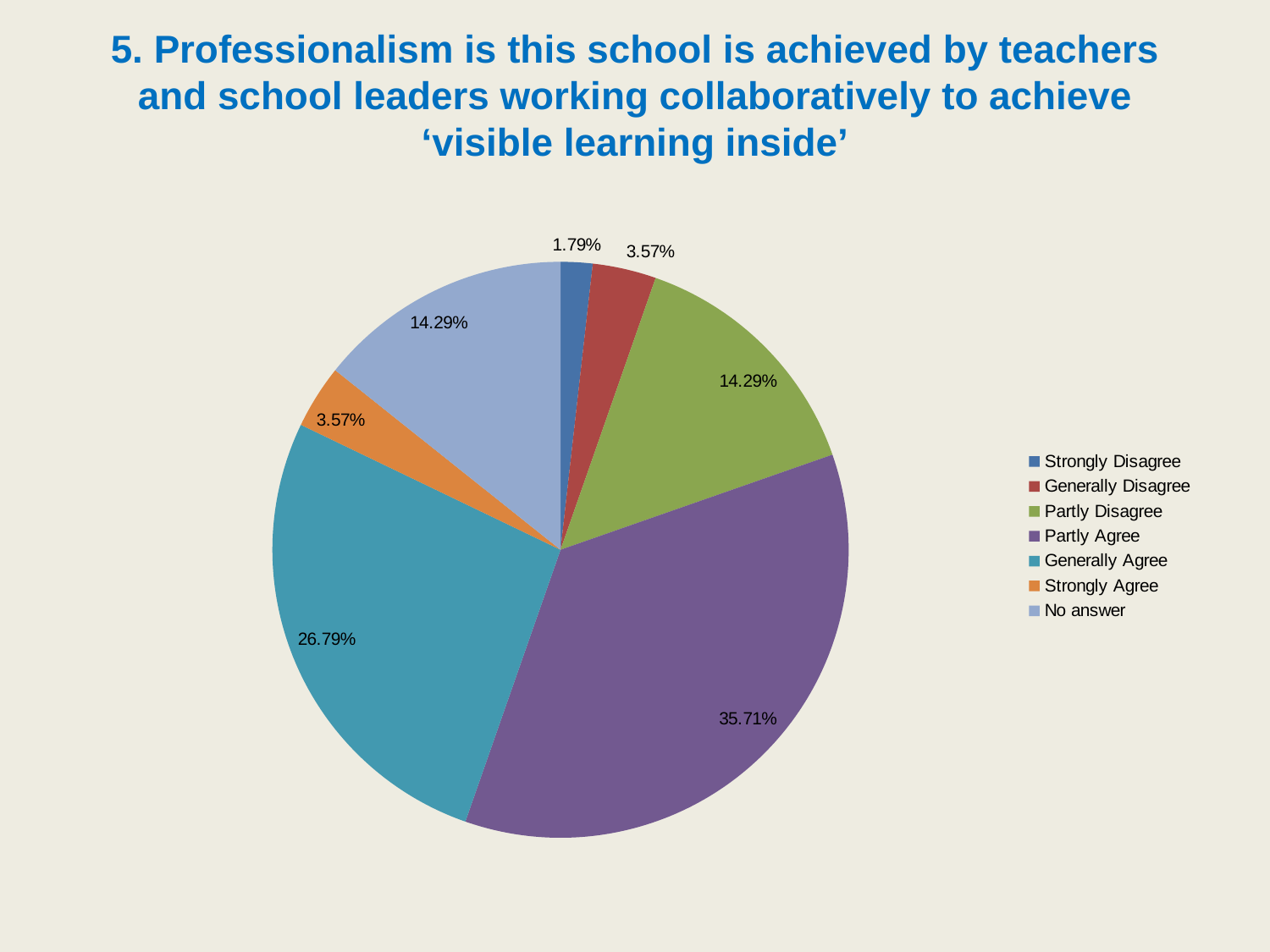
Which category has the smallest slice of the pie? Strongly Disagree What is the difference in percentage points between Partly Agree and Generally Agree? 8.92 What colour is the Generally Agree slice? Teal What percentage of the pie is Strongly Disagree? 1.79% What percentage of the pie is Strongly Agree? 3.57% Which is larger, the Partly Disagree slice or the Generally Disagree slice? Partly Disagree How many categories does the legend list? 7 What percentage of the pie is No answer? 14.29% What kind of chart is shown on the slide? Pie chart Which category has the largest slice of the pie? Partly Agree What percentage of the pie is Partly Agree? 35.71% What percentage of the pie is Generally Agree? 26.79%